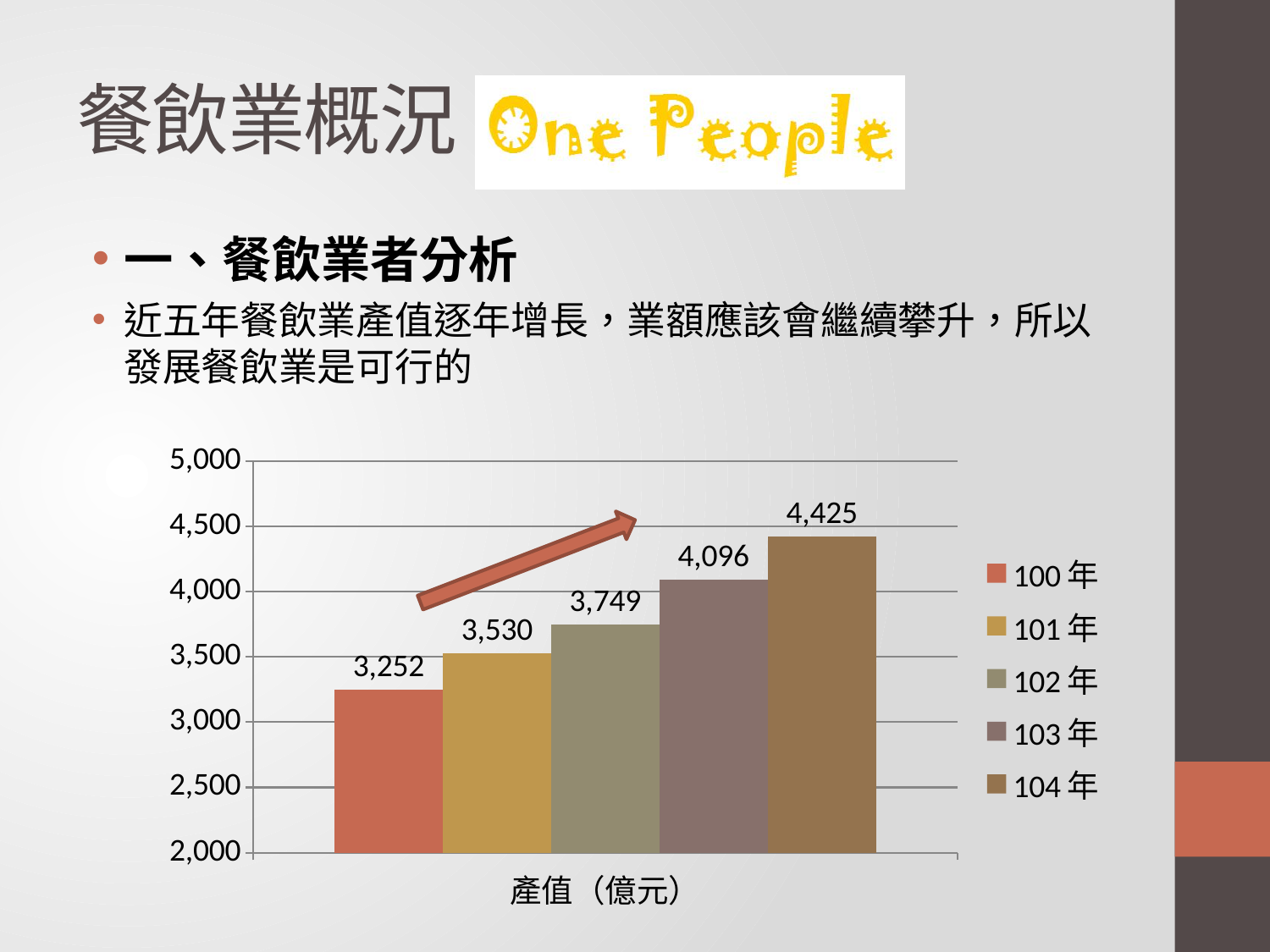
Do the values rise or fall from 100 年 to 104 年? rise What is the difference between the values for 104 年 and 100 年? 1,173 What kind of chart is shown on the slide? bar chart Which year has the lowest value? 100 年 Which is larger, the value for 101 年 or the value for 103 年? 103 年 What is the value for 104 年? 4,425 What is the value for 100 年? 3,252 What is the x-axis title of the chart? 產值（億元） Which year has the highest value? 104 年 How many series does the legend list? 5 What is the difference between the values for 103 年 and 102 年? 347 What is the value for 102 年? 3,749